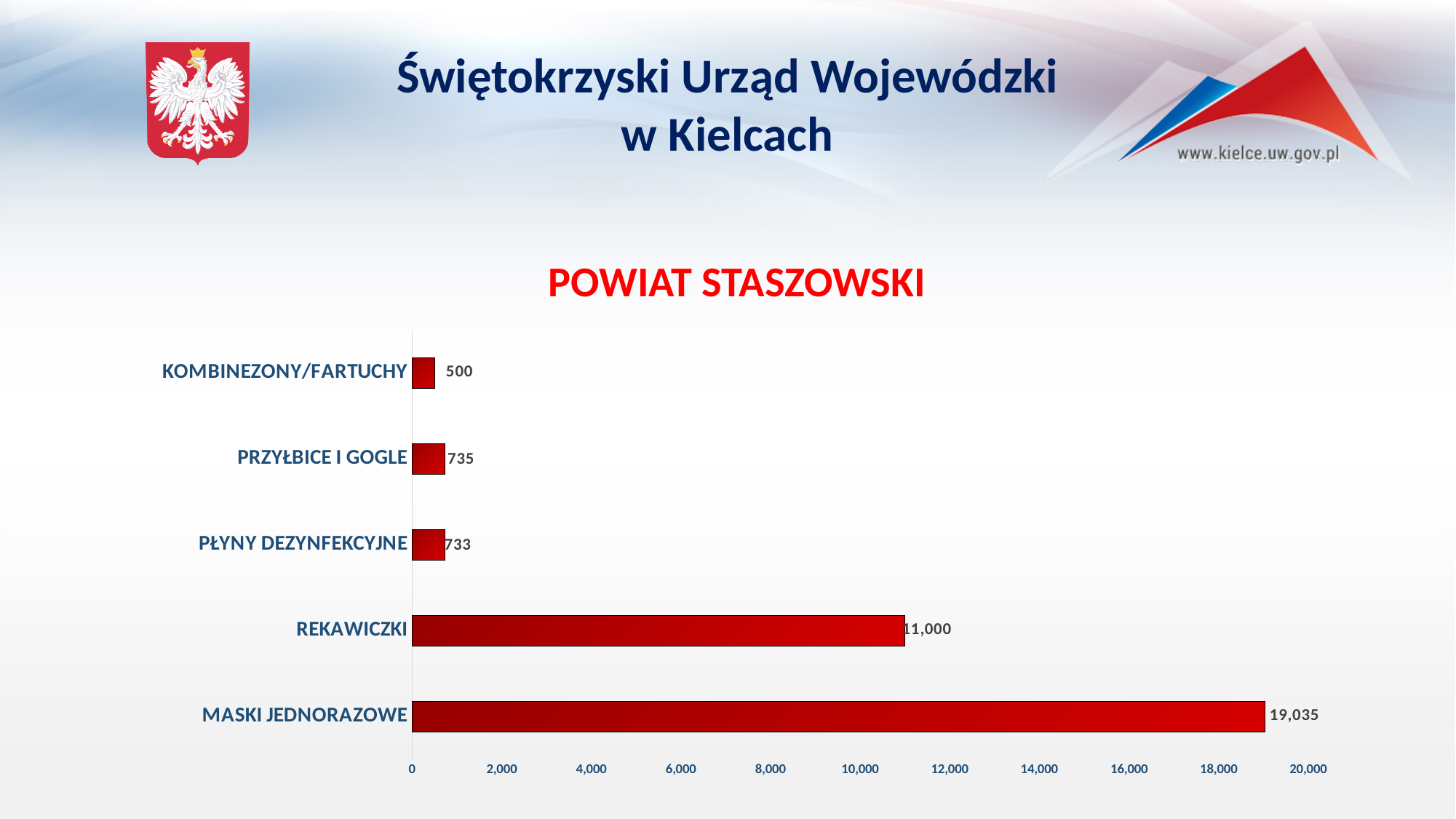
What is the value for REKAWICZKI? 11,000 What is the title of the chart? POWIAT STASZOWSKI What is the value for KOMBINEZONY/FARTUCHY? 500 Which is larger, the value for REKAWICZKI or the value for KOMBINEZONY/FARTUCHY? REKAWICZKI What kind of chart is shown on the slide? bar chart How many categories are shown in the chart? 5 What is the value for MASKI JEDNORAZOWE? 19,035 Which category has the highest value? MASKI JEDNORAZOWE What is the value for PŁYNY DEZYNFEKCYJNE? 733 What is the value for PRZYŁBICE I GOGLE? 735 What is the difference between the values for MASKI JEDNORAZOWE and REKAWICZKI? 8,035 Which category has the lowest value? KOMBINEZONY/FARTUCHY